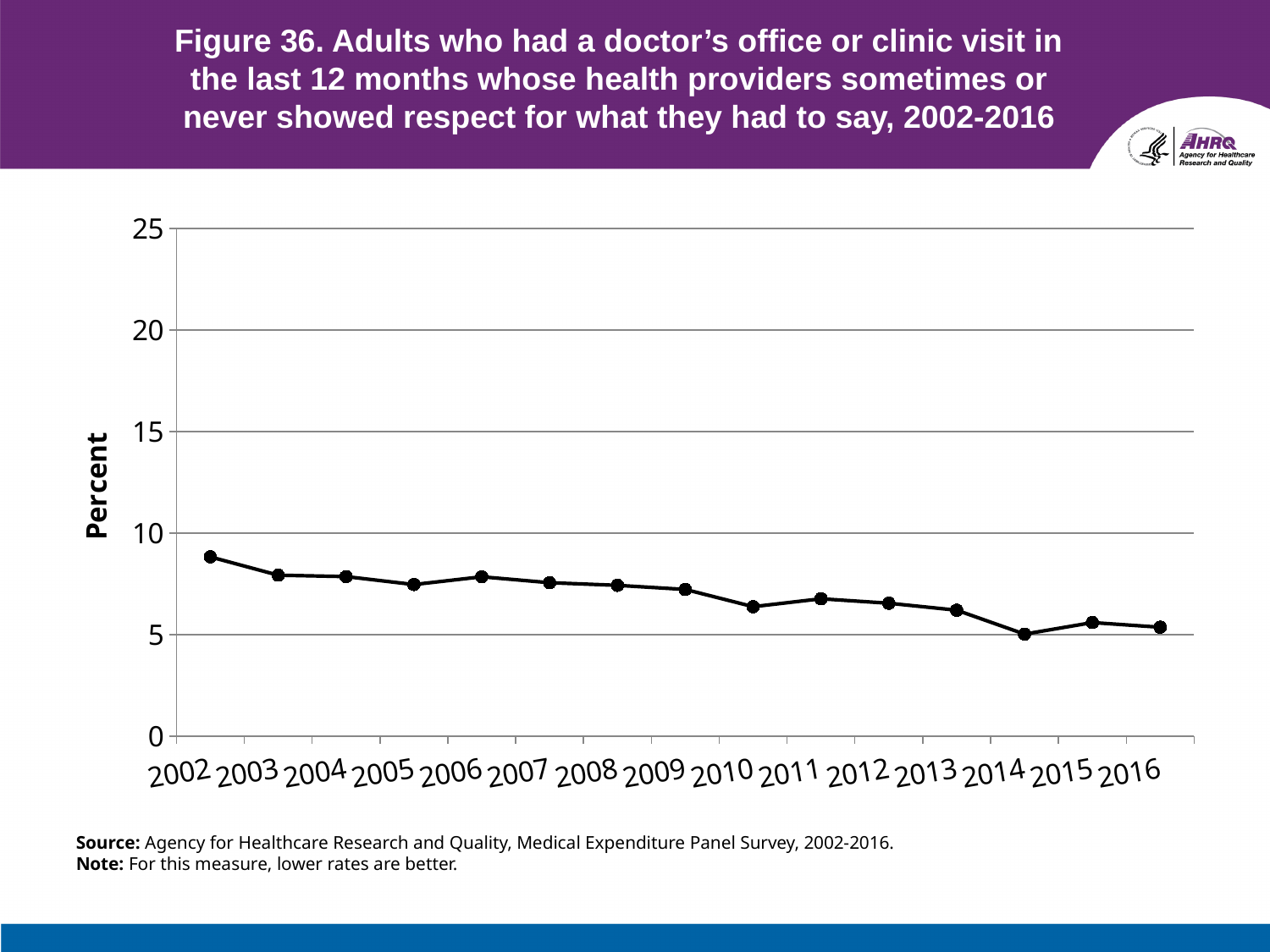
What is the label on the vertical axis of the chart? Percent Do the values generally rise or fall from 2002 to 2016? fall Is the value for 2008 greater or less than 5? greater Which year has the highest value on the chart? 2002 Which year has the lowest value on the chart? 2014 Is the value for 2002 greater or less than 5? greater How many years (data points) are plotted on the chart? 15 Which year has the larger value, 2002 or 2016? 2002 Is the value for 2010 greater or less than 10? less What kind of chart is shown on the slide? line chart Which year has the larger value, 2009 or 2014? 2009